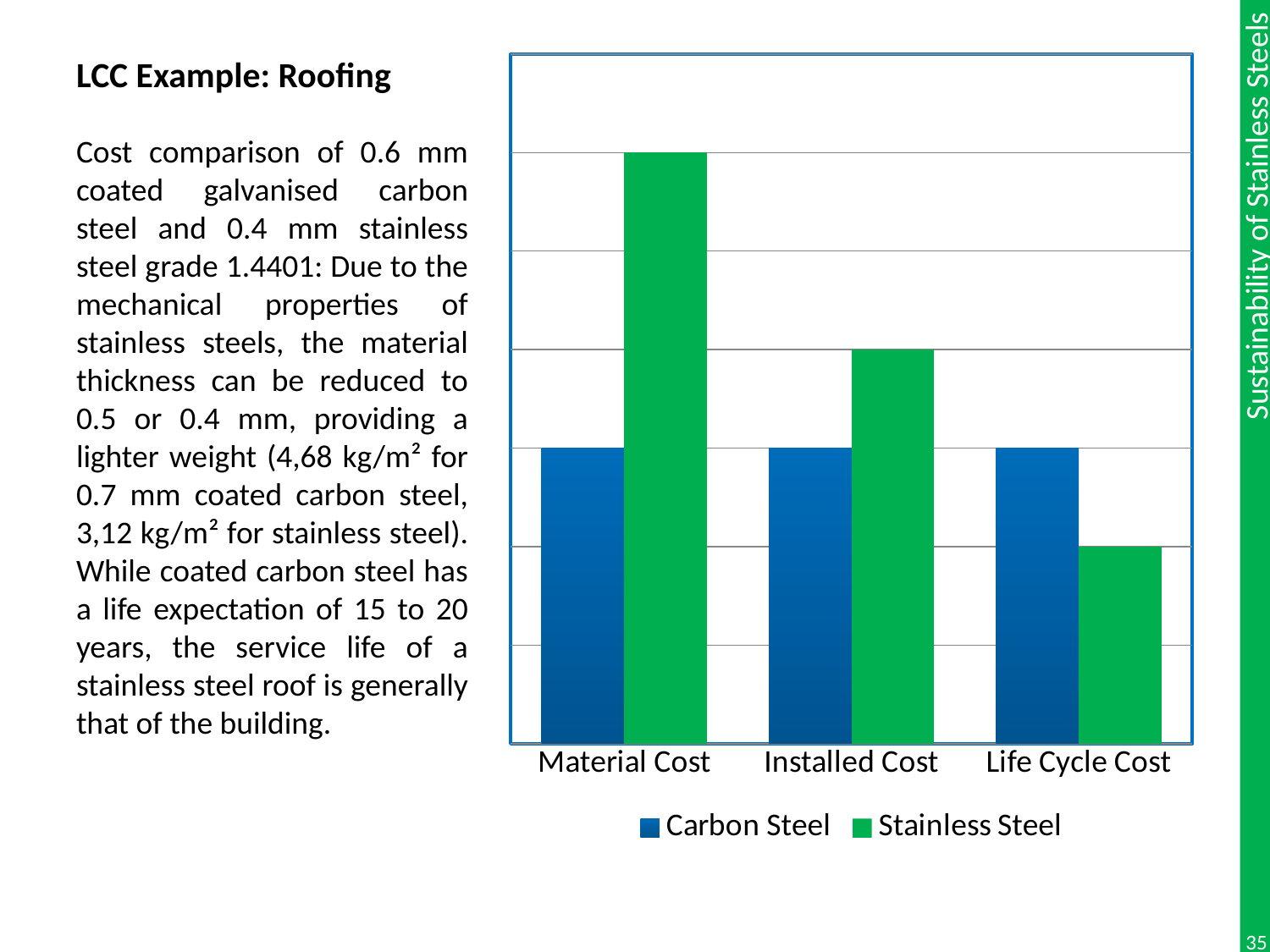
Do the Stainless Steel bars rise or fall from Material Cost to Life Cycle Cost? fall For which cost category is the Stainless Steel bar the lowest? Life Cycle Cost For which cost category is the Stainless Steel bar the highest? Material Cost Which category is shown in the middle position on the x axis? Installed Cost For Life Cycle Cost, which series has the larger bar, Carbon Steel or Stainless Steel? Carbon Steel What colour are the Stainless Steel bars in the chart? green How many series does the chart's legend list? 2 What kind of chart is shown on the slide? bar chart How many cost categories are shown on the x axis of the chart? 3 Which two series are listed in the chart's legend? Carbon Steel and Stainless Steel For Material Cost, which series has the larger bar, Carbon Steel or Stainless Steel? Stainless Steel For Installed Cost, which series has the larger bar, Carbon Steel or Stainless Steel? Stainless Steel